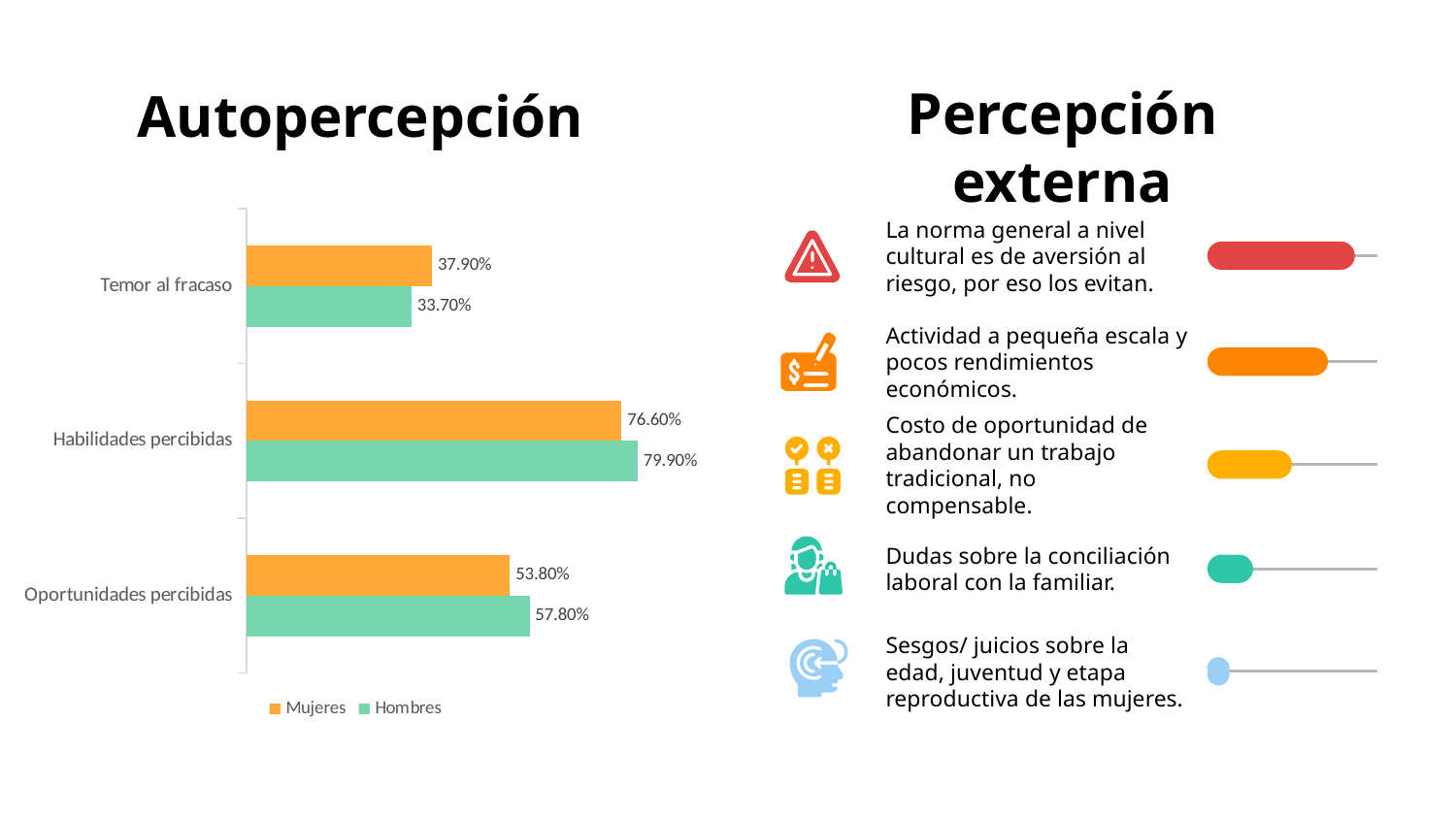
What is the value for Mujeres in the Temor al fracaso category? 37.90% What is the value for Mujeres in the Oportunidades percibidas category? 53.80% What is the difference between the Hombres and Mujeres values for Habilidades percibidas? 3.30% What kind of chart is shown on the slide? Bar chart What is the value for Hombres in the Temor al fracaso category? 33.70% Which category has the lowest value for the Mujeres series? Temor al fracaso What is the difference between the Mujeres and Hombres values for Temor al fracaso? 4.20% How many categories are shown in the chart? 3 Which category has the highest value for the Hombres series? Habilidades percibidas How many series does the legend list? 2 What is the value for Hombres in the Habilidades percibidas category? 79.90% For Oportunidades percibidas, which series has the larger value, Mujeres or Hombres? Hombres